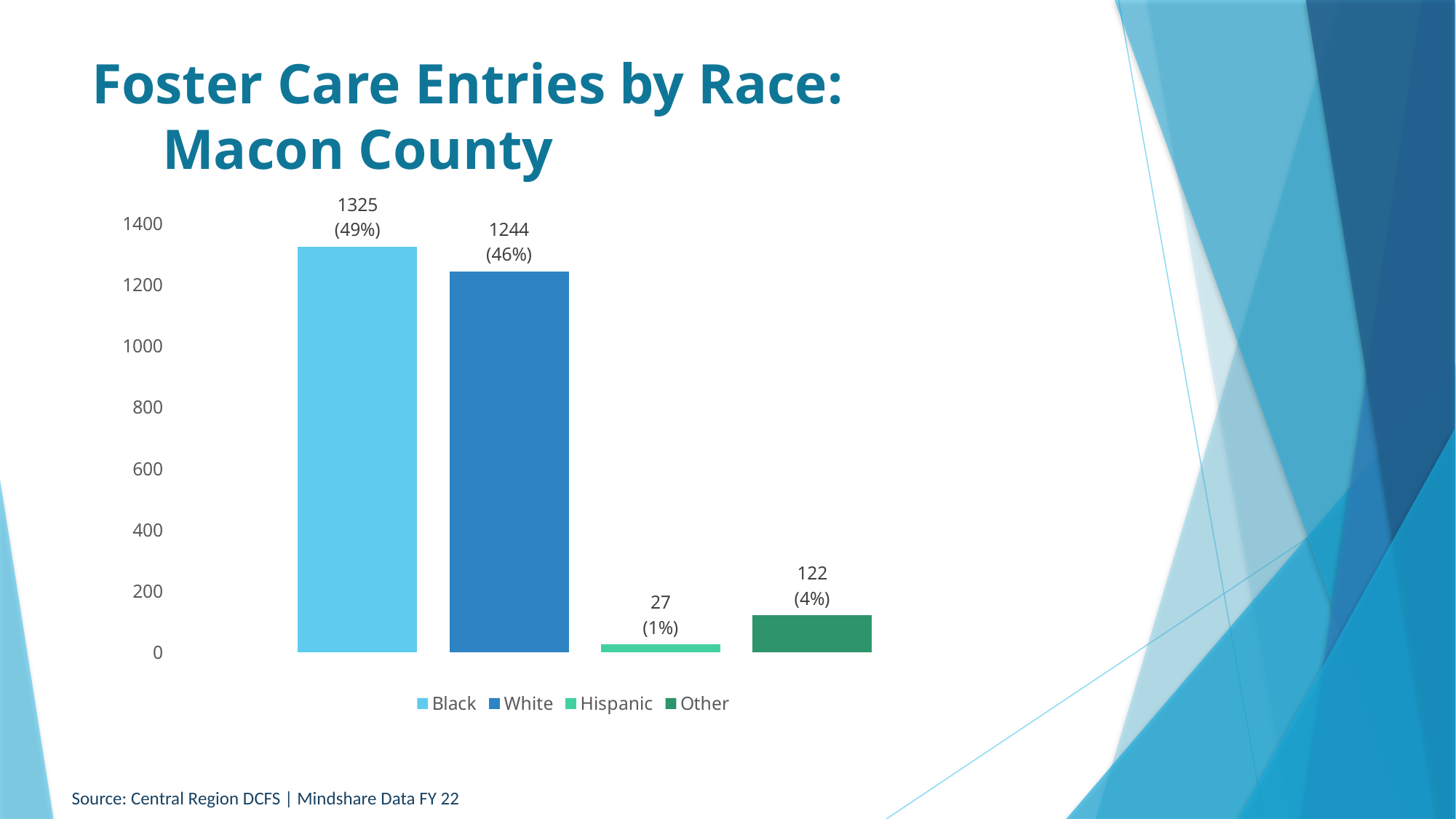
What is the number of foster care entries for White children in Macon County? 1244 Which race category has the highest number of foster care entries? Black How many race categories are plotted in the chart? 4 What is the difference between the foster care entries for Black and White children? 81 What is the number of foster care entries for the Other category? 122 Which race category has the lowest number of foster care entries? Hispanic Which has more foster care entries, Other or Hispanic? Other What is the number of foster care entries for Black children in Macon County? 1325 What percentage of foster care entries is shown for Hispanic children? 1% What is the total of the foster care entries for Black and White children combined? 2569 What kind of chart is shown on the slide? Bar chart Is the value for White greater or less than 1000? greater